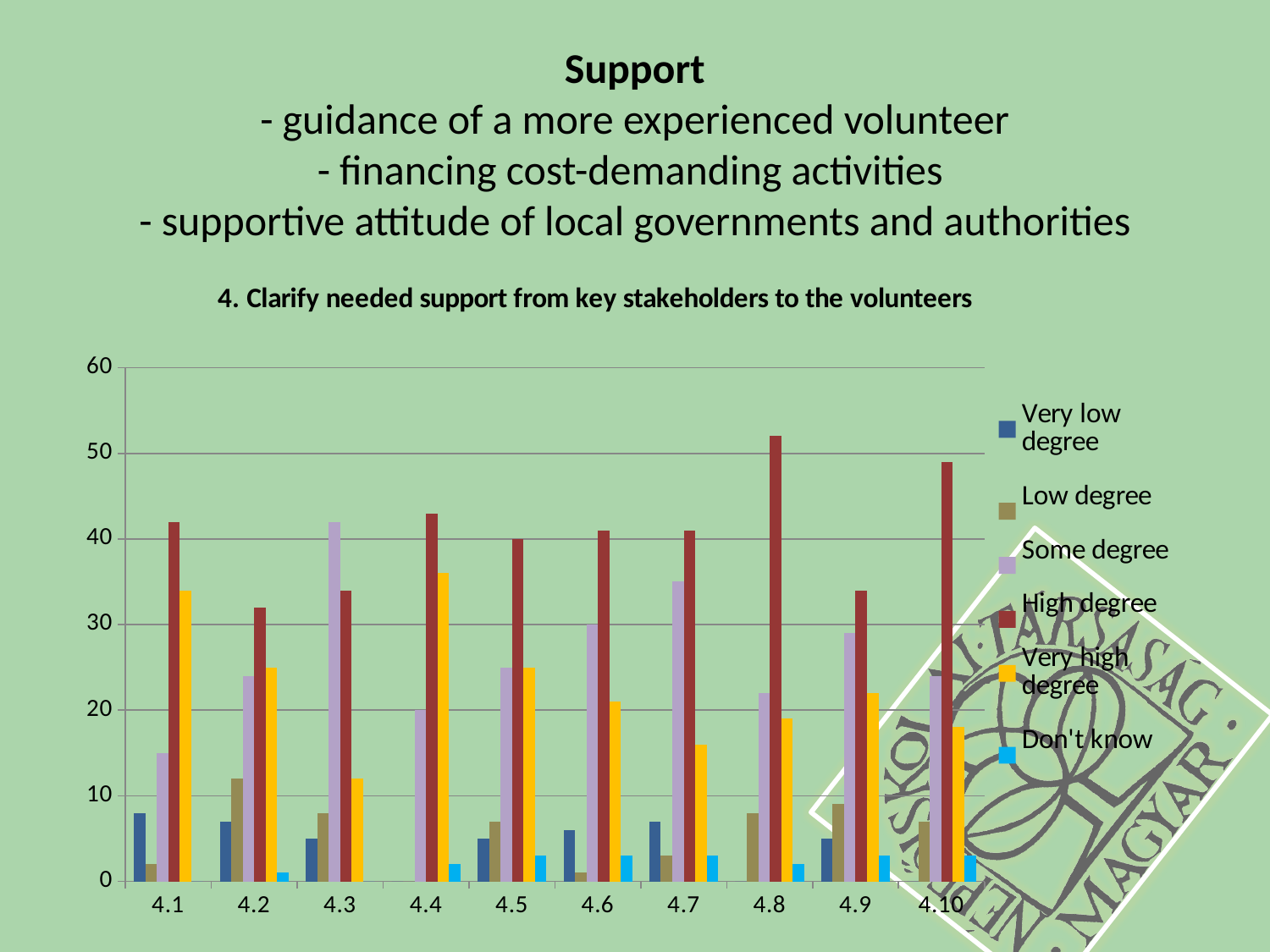
For category 4.3, which is larger: Some degree or High degree? Some degree How many categories are shown on the x axis? 10 Is the Some degree value for 4.3 greater or less than 40? greater What is the title of the chart? 4. Clarify needed support from key stakeholders to the volunteers Is the Very low degree value for 4.1 greater or less than 10? less Is the Very high degree value for 4.1 greater or less than 30? greater Which category has the highest Some degree bar? 4.3 How many series does the legend list? 6 What kind of chart is shown on the slide? bar chart Which category has the highest High degree bar? 4.8 For category 4.1, which is larger: High degree or Very high degree? High degree